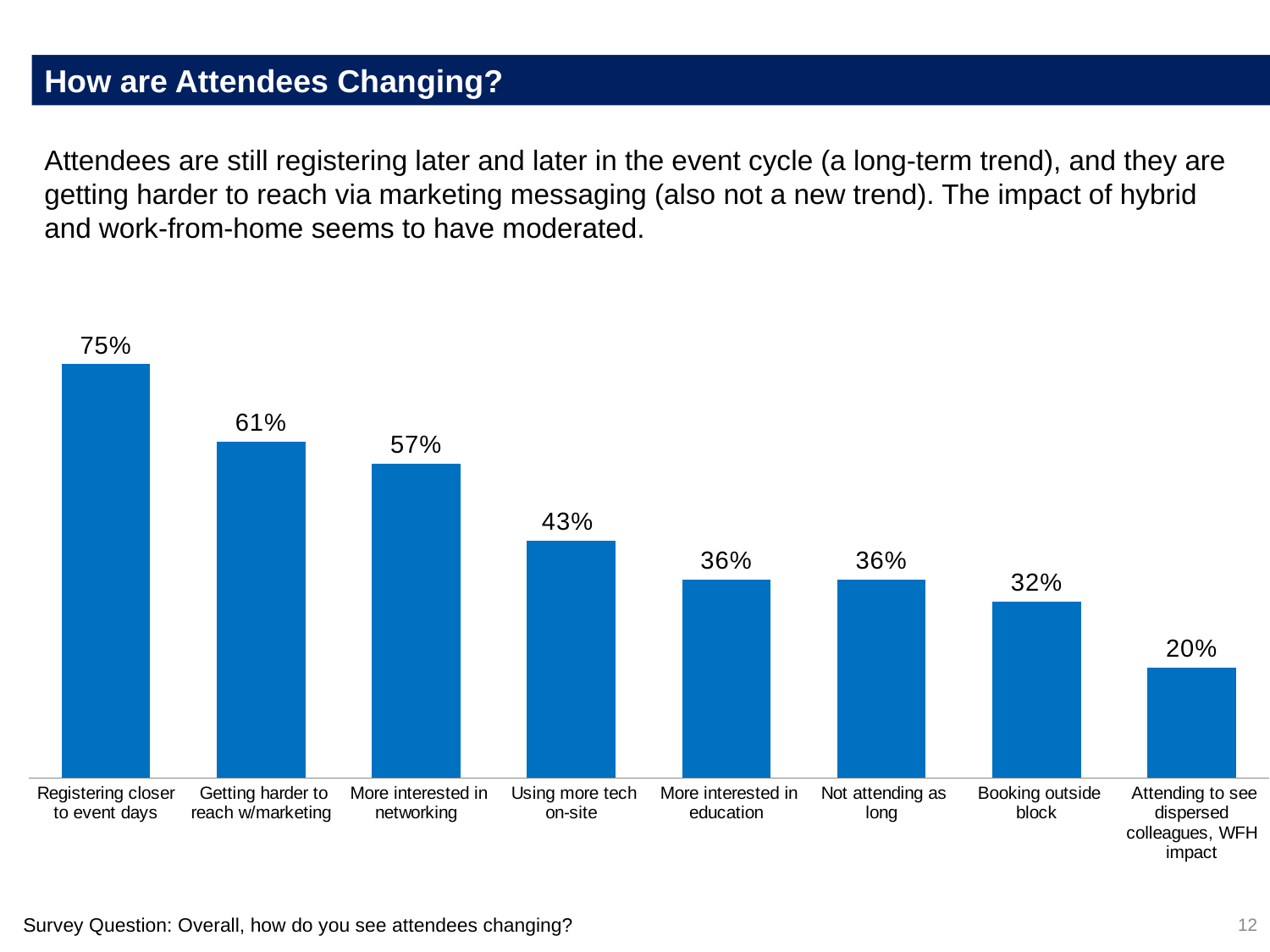
Which is larger, the value for "Using more tech on-site" or the value for "More interested in education"? Using more tech on-site Which two categories share the same value of 36%? More interested in education; Not attending as long What is the value for "Booking outside block"? 32% Which category has the lowest value? Attending to see dispersed colleagues, WFH impact How many categories are shown in the chart? 8 What percentage of respondents said attendees are registering closer to event days? 75% What is the difference between "Registering closer to event days" and "Attending to see dispersed colleagues, WFH impact"? 55% What is the value for "Using more tech on-site"? 43% What kind of chart is shown on the slide? Bar chart What is the difference between "Getting harder to reach w/marketing" and "More interested in networking"? 4% Do the values rise or fall from left to right across the chart? Fall Which category has the highest value? Registering closer to event days